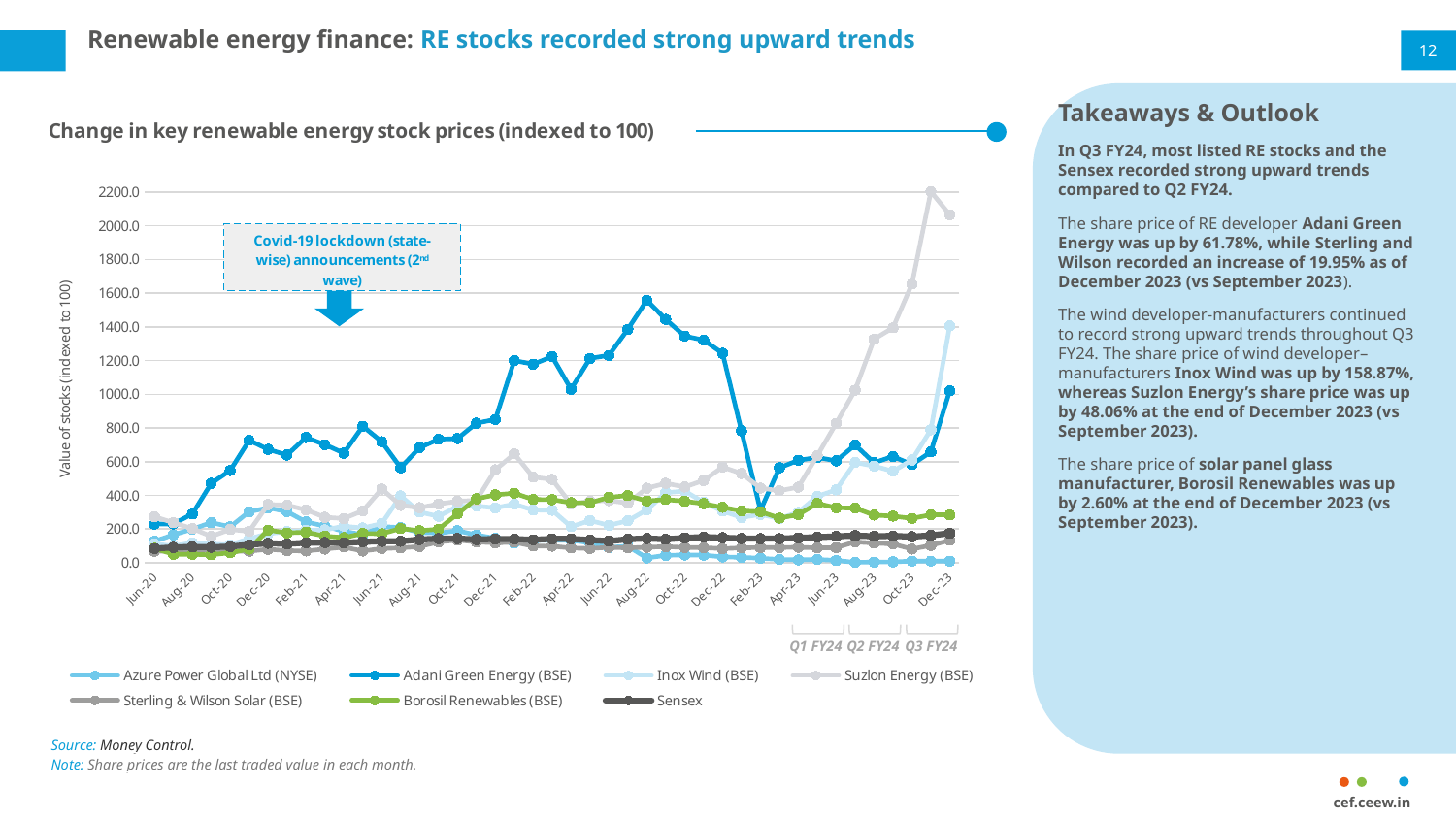
Is the value for Adani Green Energy (BSE) at Aug-22 greater or less than 1400? greater Is the value for Adani Green Energy (BSE) at Feb-23 greater or less than 400? less What kind of chart is shown on the slide? Line chart Is the value for Inox Wind (BSE) at Dec-23 greater or less than 1200? greater Which series reaches the highest value anywhere on the chart? Suzlon Energy (BSE) What is the title of the chart? Change in key renewable energy stock prices (indexed to 100) Which series has the lowest value at Dec-23? Azure Power Global Ltd (NYSE) Does the Suzlon Energy (BSE) line rise or fall between Jun-23 and Nov-23? Rise How many series does the chart legend list? 7 What event does the dashed annotation box on the chart refer to? Covid-19 lockdown (state-wise) announcements (2nd wave) At Dec-23, which is larger: Suzlon Energy (BSE) or Adani Green Energy (BSE)? Suzlon Energy (BSE)